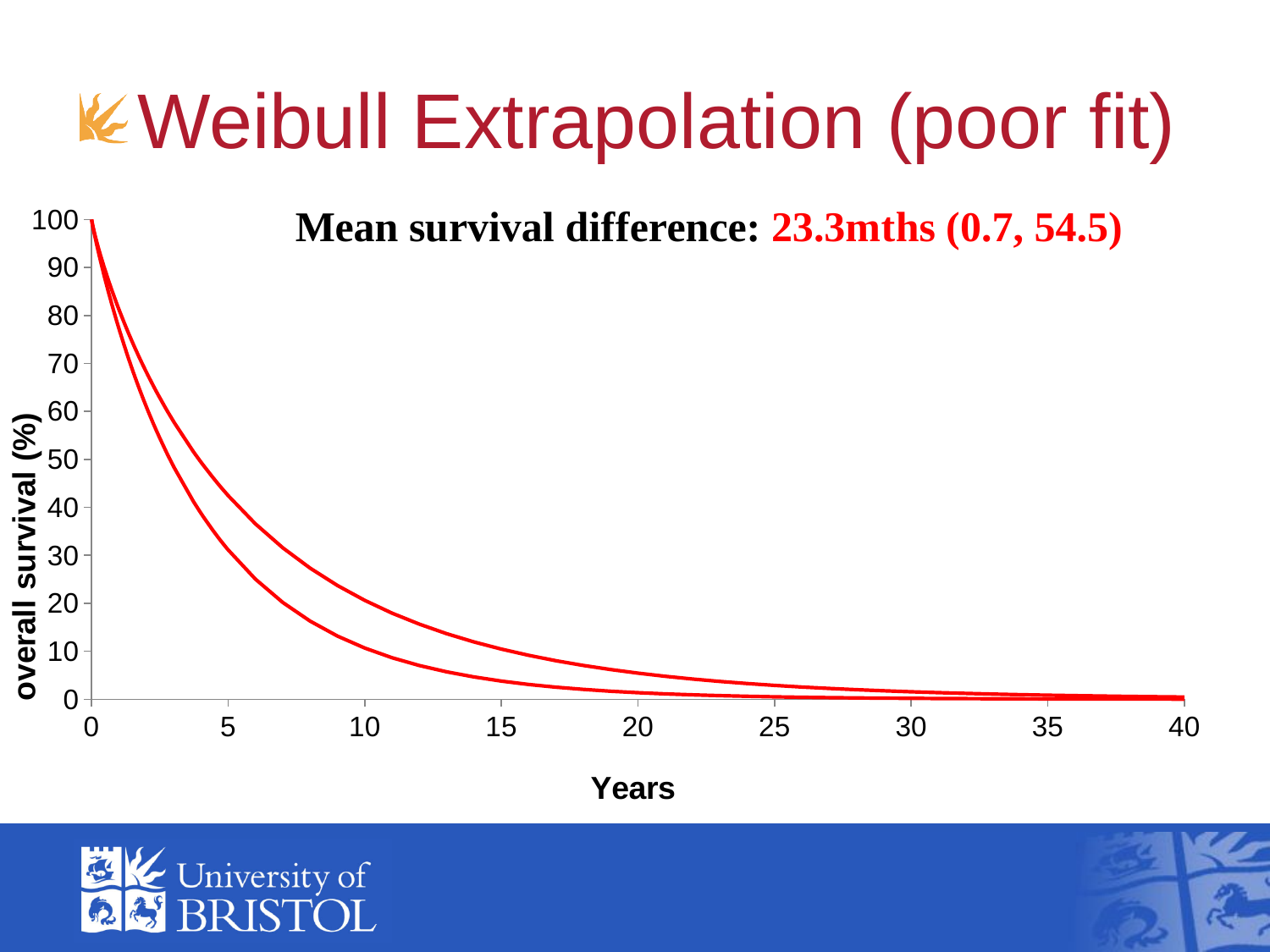
What overall survival value do both curves start at when Years is 0? 100 Is the value of the lower curve at 5 years greater or less than 50? less Is the value of the upper curve at 20 years greater or less than 10? less Is the value of the upper curve at 10 years greater or less than 30? less How many curves are plotted on the chart? 2 What is the label of the x axis? Years What is the label of the y axis? overall survival (%) Do the survival curves rise or fall as years increase? fall What mean survival difference is stated on the chart? 23.3mths (0.7, 54.5) What kind of chart is shown on the slide? line chart